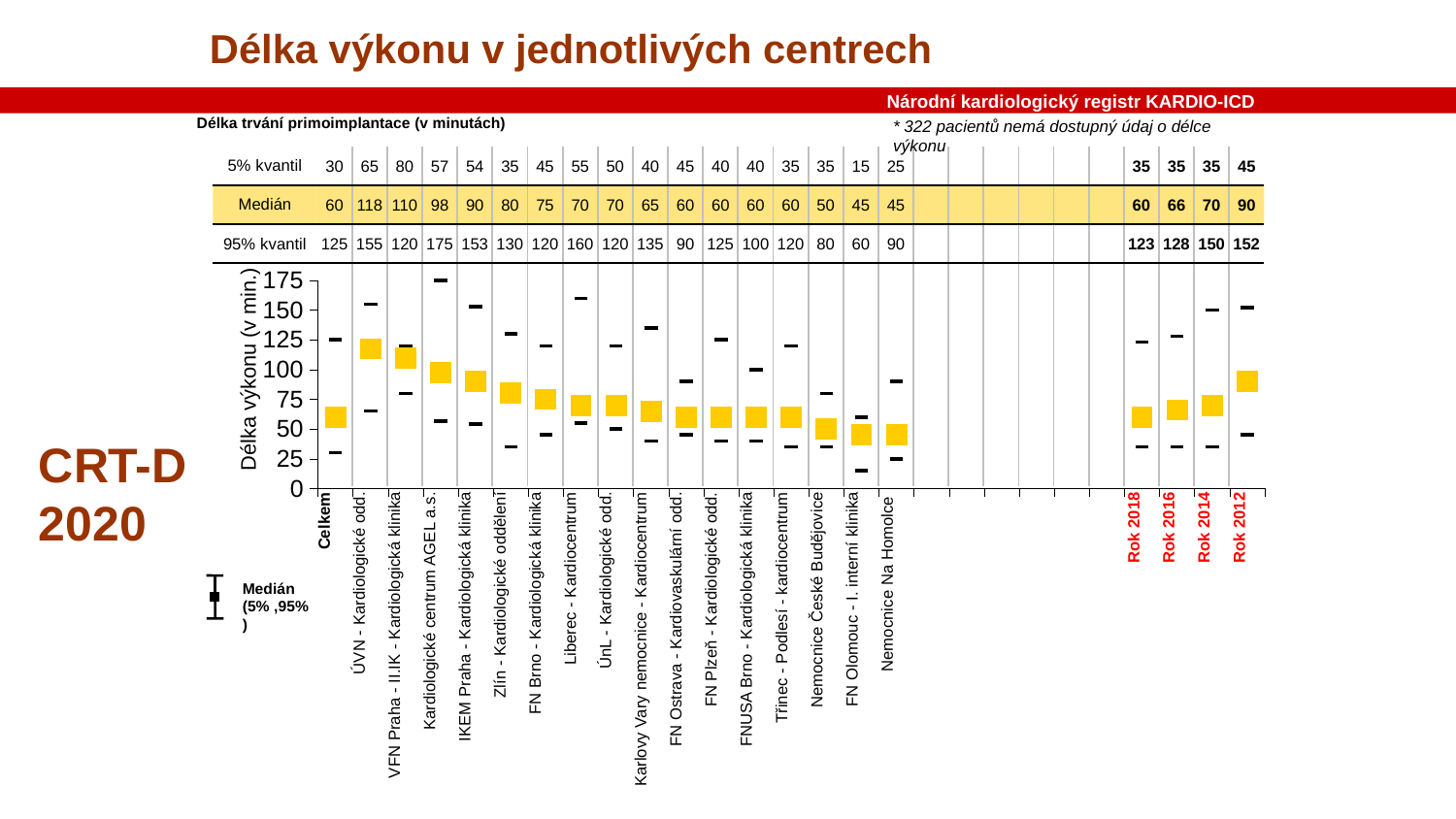
How many year columns (Rok) are shown on the right side of the chart? 4 Does the median procedure duration rise or fall from Rok 2018 to Rok 2012 along the x axis? rise What is the 5% kvantil value for FN Olomouc - I. interní klinika? 15 What is the median (Medián) procedure duration for ÚVN - Kardiologické odd.? 118 What is the median (Medián) value for Rok 2012? 90 What is the difference between the median for ÚVN - Kardiologické odd. and the median for Celkem? 58 Which has a higher median: IKEM Praha - Kardiologická klinika or Zlín - Kardiologické oddělení? IKEM Praha - Kardiologická klinika What is the 95% kvantil value for Kardiologické centrum AGEL a.s.? 175 Which centre has the highest median (Medián) procedure duration? ÚVN - Kardiologické odd. What is the label on the y axis of the chart? Délka výkonu (v min.) Which centre has the lowest 5% kvantil value? FN Olomouc - I. interní klinika Is the 95% kvantil value for Liberec - Kardiocentrum greater or less than 150? greater